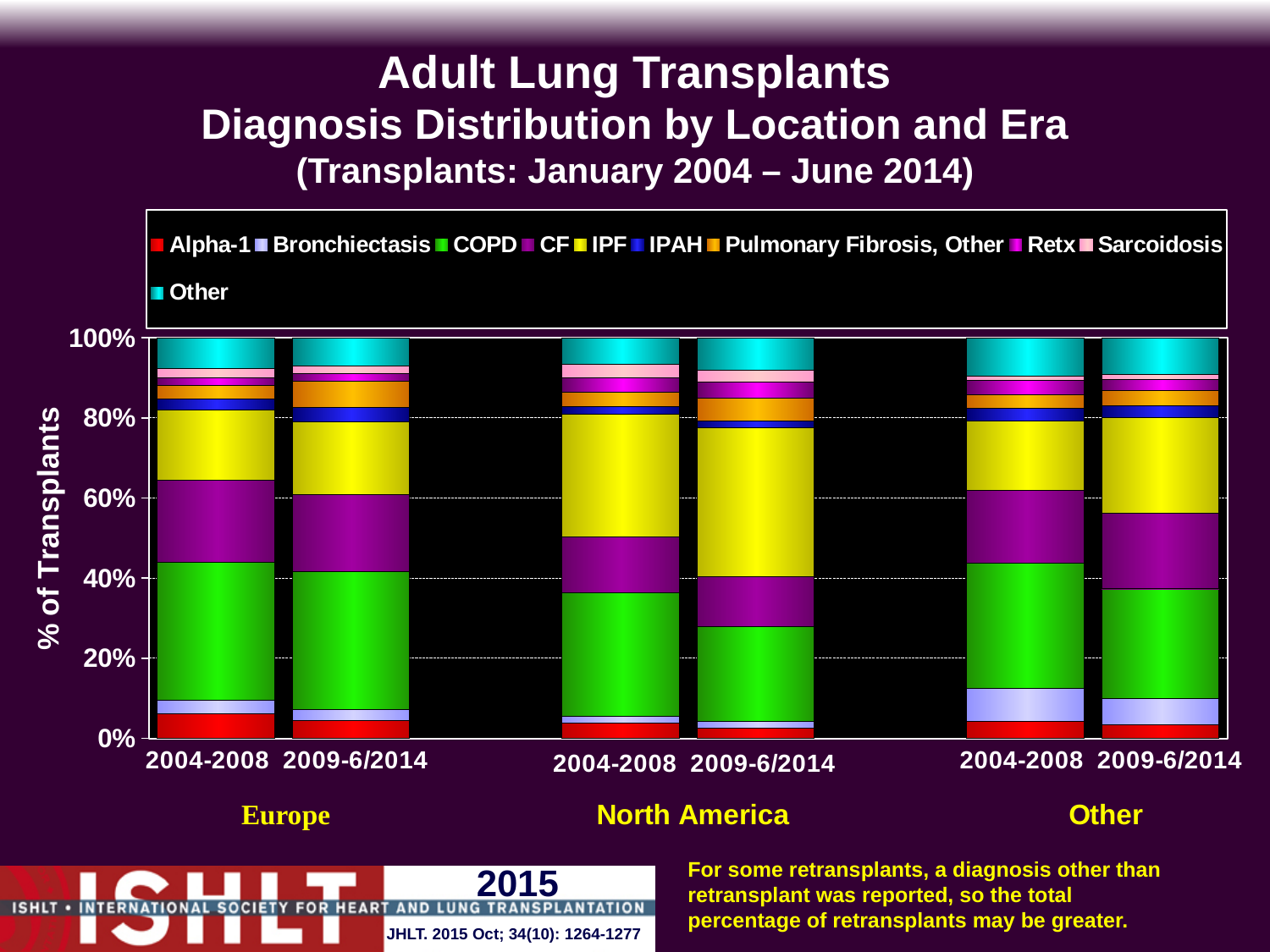
Is the IPF share larger for North America 2009-6/2014 or for Europe 2009-6/2014? North America 2009-6/2014 Is the COPD share for Europe 2004-2008 greater or less than 20%? greater How many locations are shown along the x axis? 3 Which location has the largest IPF share in the 2009-6/2014 era? North America How many bars are plotted in the chart? 6 What kind of chart is shown on the slide? Stacked bar chart Is the COPD share larger for Europe 2004-2008 or for North America 2009-6/2014? Europe 2004-2008 What is the label of the y axis? % of Transplants Is the Alpha-1 share for North America 2009-6/2014 greater or less than 20%? less Is the IPF share for North America 2009-6/2014 greater or less than 20%? greater Which two eras are compared for each location? 2004-2008 and 2009-6/2014 How many series does the legend list? 10